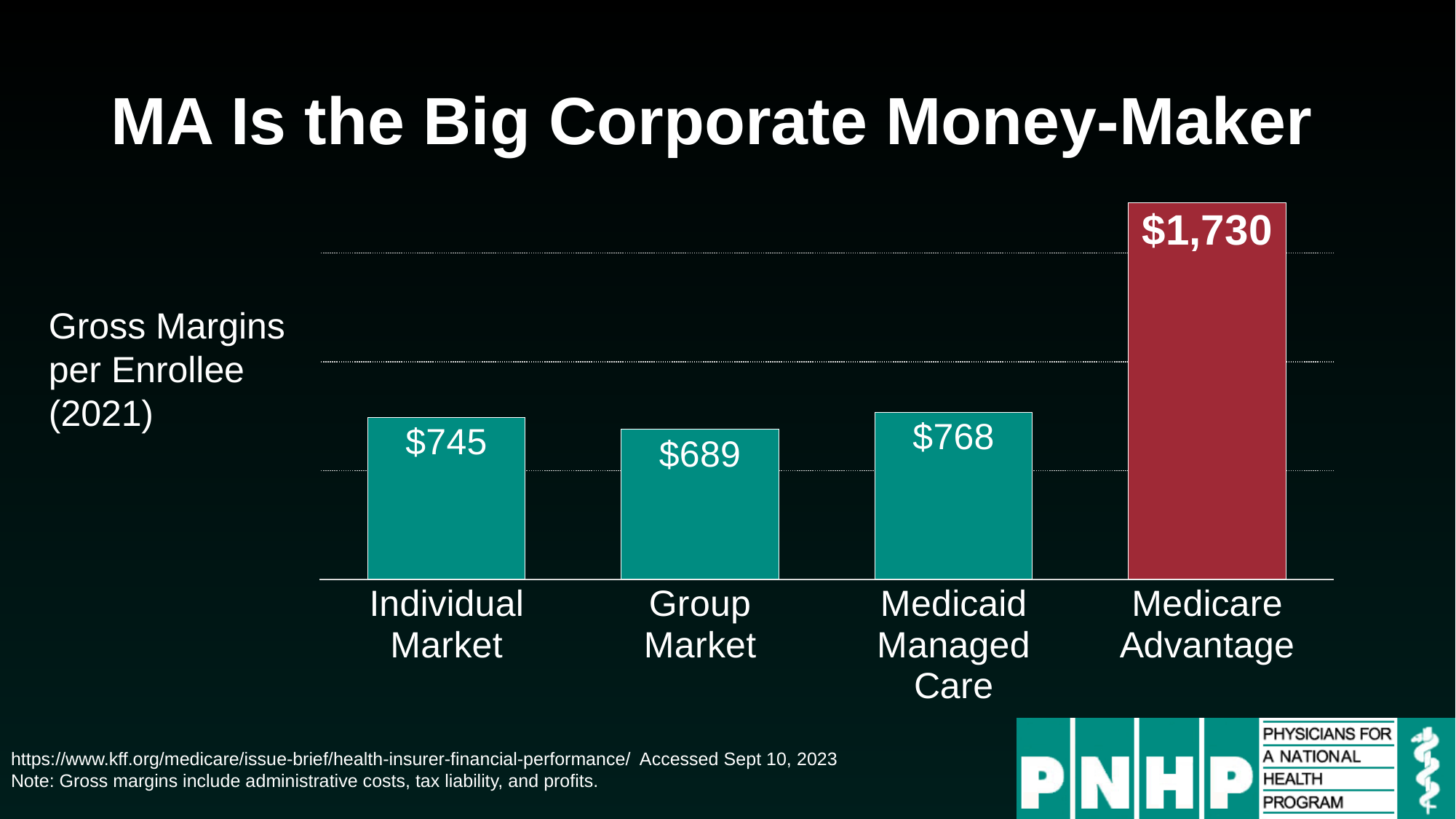
What is the difference between the gross margin per enrollee for Medicare Advantage and for Medicaid Managed Care? $962 Which category has the highest gross margin per enrollee? Medicare Advantage Which bar is shown in a different colour (red) from the others? Medicare Advantage What is the difference between the gross margin per enrollee for the Individual Market and the Group Market? $56 How many categories are shown in the chart? 4 What kind of chart is shown on the slide? Bar chart Which category has the lowest gross margin per enrollee? Group Market What is the gross margin per enrollee for the Group Market? $689 What is the gross margin per enrollee for the Individual Market? $745 What is the gross margin per enrollee for Medicaid Managed Care? $768 Which has a larger gross margin per enrollee, Medicaid Managed Care or the Individual Market? Medicaid Managed Care What is the gross margin per enrollee for Medicare Advantage? $1,730